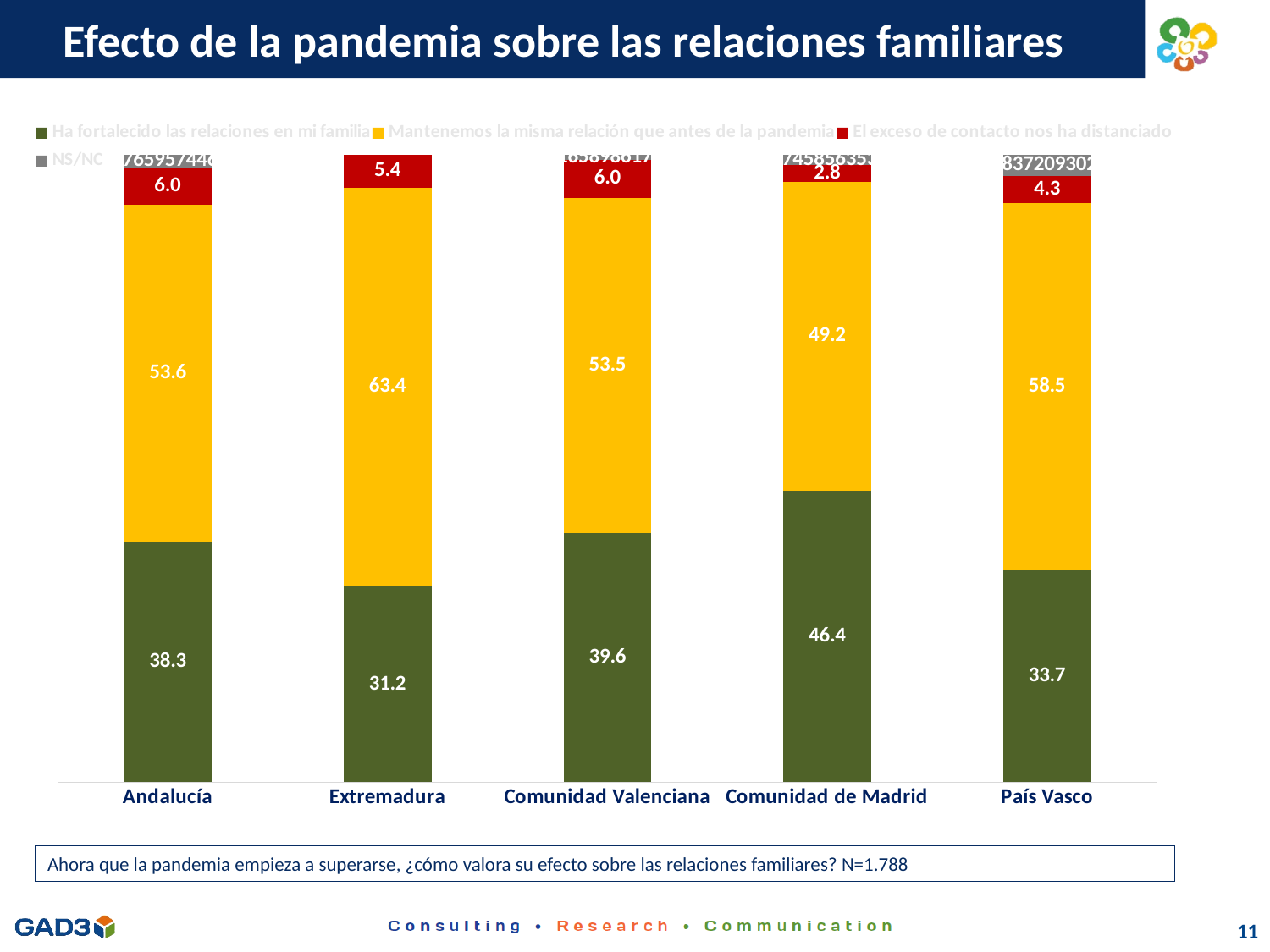
How many series does the legend list? 4 Which region has the highest value for 'Ha fortalecido las relaciones en mi familia'? Comunidad de Madrid Which region has the lowest value for 'Mantenemos la misma relación que antes de la pandemia'? Comunidad de Madrid What is the value of 'Mantenemos la misma relación que antes de la pandemia' for Extremadura? 63.4 What colour represents the series 'El exceso de contacto nos ha distanciado'? Red What type of chart is shown on the slide? Stacked bar chart What is the value of 'Ha fortalecido las relaciones en mi familia' for Comunidad de Madrid? 46.4 What is the value of 'El exceso de contacto nos ha distanciado' for País Vasco? 4.3 Which is larger: the 'Mantenemos la misma relación que antes de la pandemia' value for País Vasco or for Andalucía? País Vasco How many regions (categories) are shown on the x axis? 5 Which region has the lowest value for 'El exceso de contacto nos ha distanciado'? Comunidad de Madrid What is the difference between the 'Ha fortalecido las relaciones en mi familia' values for Comunidad de Madrid and Extremadura? 15.2